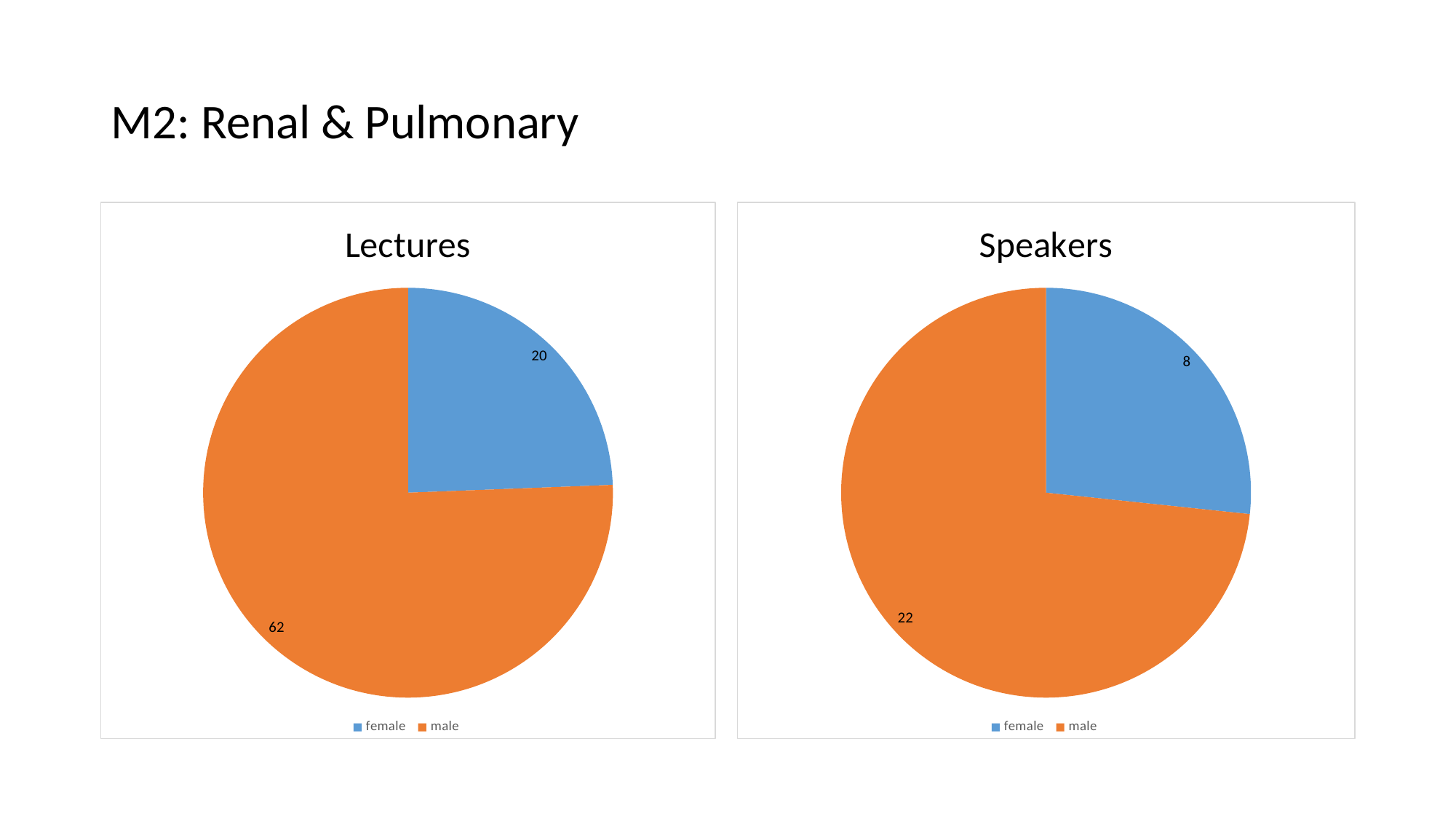
In the Speakers chart, what is the difference between the male and female values? 14 In the Lectures chart, what colour is the female slice? blue In the Speakers chart, what is the value for female? 8 In the Speakers chart, what is the value for male? 22 In the Lectures chart, what is the value for male? 62 In the Lectures chart, which category has the largest slice? male In the Speakers chart, is the value for male or female larger? male In the Lectures chart, what is the difference between the male and female values? 42 How many categories does the Speakers chart show? 2 What kind of chart is the Lectures chart? pie chart In the Speakers chart, which category has the smallest slice? female In the Lectures chart, what is the value for female? 20